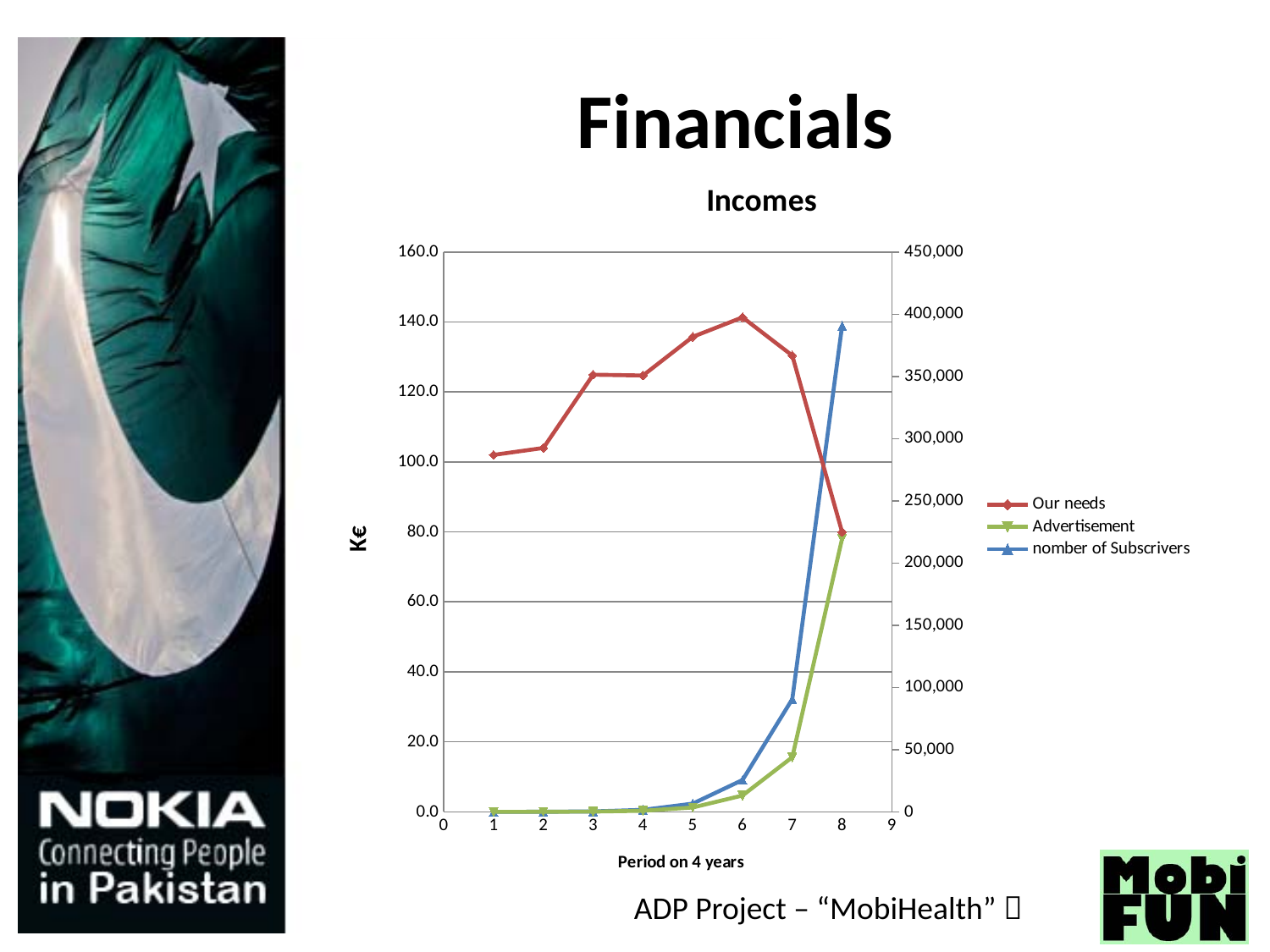
How many series does the legend of the Incomes chart list? 3 Is the value for Our needs at period 8 greater or less than 100? less What is the label of the x axis of the Incomes chart? Period on 4 years Is the value for nomber of Subscrivers at period 8 greater or less than 350,000 on the right axis? greater Does the Advertisement series rise or fall from period 5 to period 8? rise How many data points are plotted for the Our needs series? 8 Is the value for Advertisement at period 8 greater or less than 60? greater What kind of chart is shown on the slide? line chart At which period does the Our needs series reach its highest value? 6 What is the title of the chart? Incomes At which period does the Our needs series reach its lowest value? 8